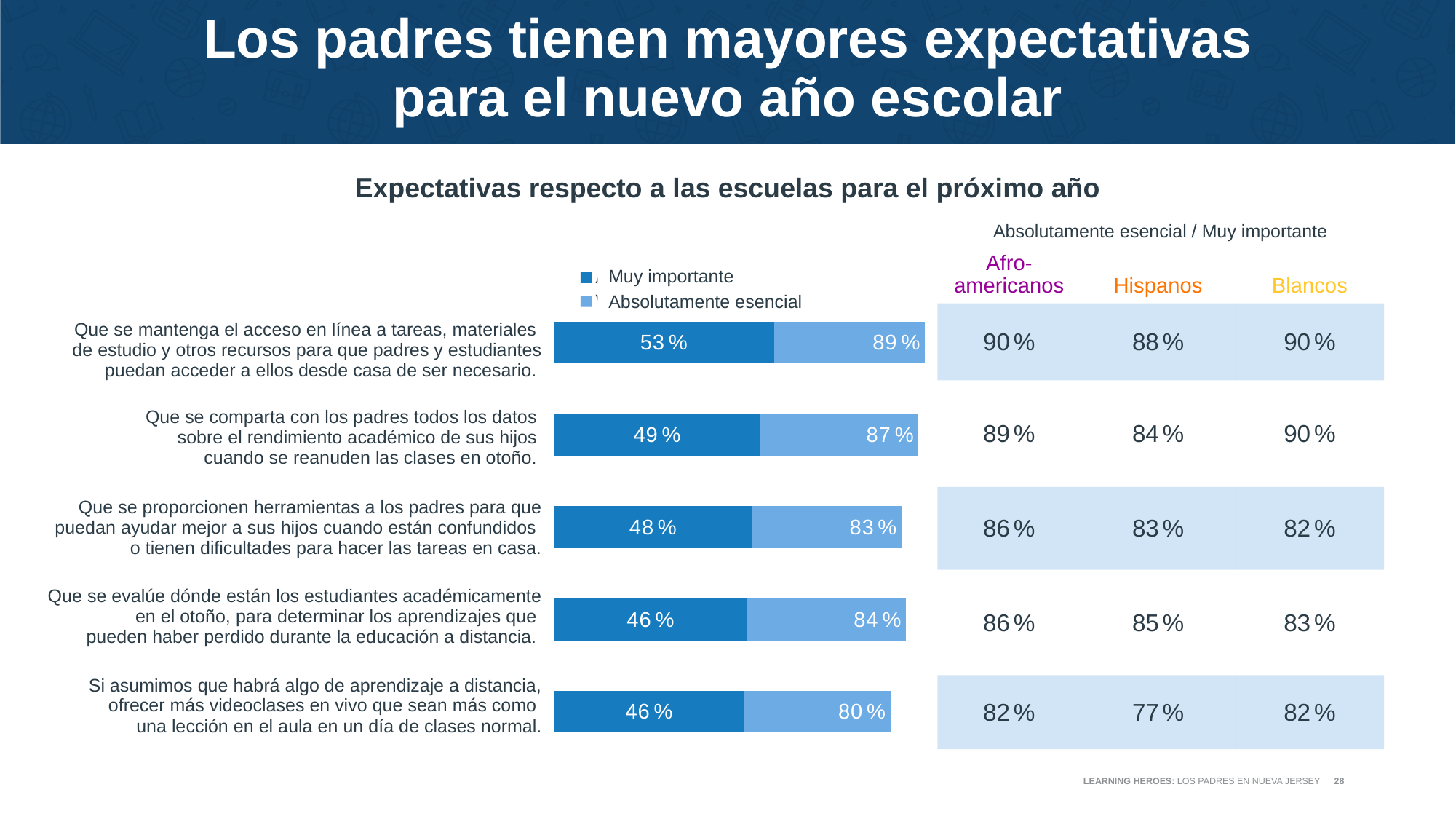
How many series does the chart legend list? 2 Which category has the highest 'Muy importante' value? Que se mantenga el acceso en línea a tareas, materiales de estudio y otros recursos How many categories (expectations) are plotted in the chart? 5 What is the difference between the 'Muy importante' values for 'Que se mantenga el acceso en línea...' (53%) and 'Que se comparta con los padres todos los datos...' (49%)? 4 percentage points What kind of chart is shown on the slide? Bar chart What value is printed on the 'Absolutamente esencial' segment for 'Que se comparta con los padres todos los datos sobre el rendimiento académico de sus hijos...'? 87% Which category has the lowest value printed on its 'Absolutamente esencial' segment? Si asumimos que habrá algo de aprendizaje a distancia, ofrecer más videoclases en vivo What is the title of the chart? Expectativas respecto a las escuelas para el próximo año What is the 'Muy importante' value for 'Que se mantenga el acceso en línea a tareas, materiales de estudio y otros recursos...'? 53% What value is printed on the 'Absolutamente esencial' segment for 'Si asumimos que habrá algo de aprendizaje a distancia, ofrecer más videoclases en vivo...'? 80% What is the 'Muy importante' value for 'Que se proporcionen herramientas a los padres para que puedan ayudar mejor a sus hijos...'? 48% Which has the larger 'Muy importante' value: 'Que se proporcionen herramientas a los padres...' or 'Que se evalúe dónde están los estudiantes académicamente en el otoño...'? Que se proporcionen herramientas a los padres